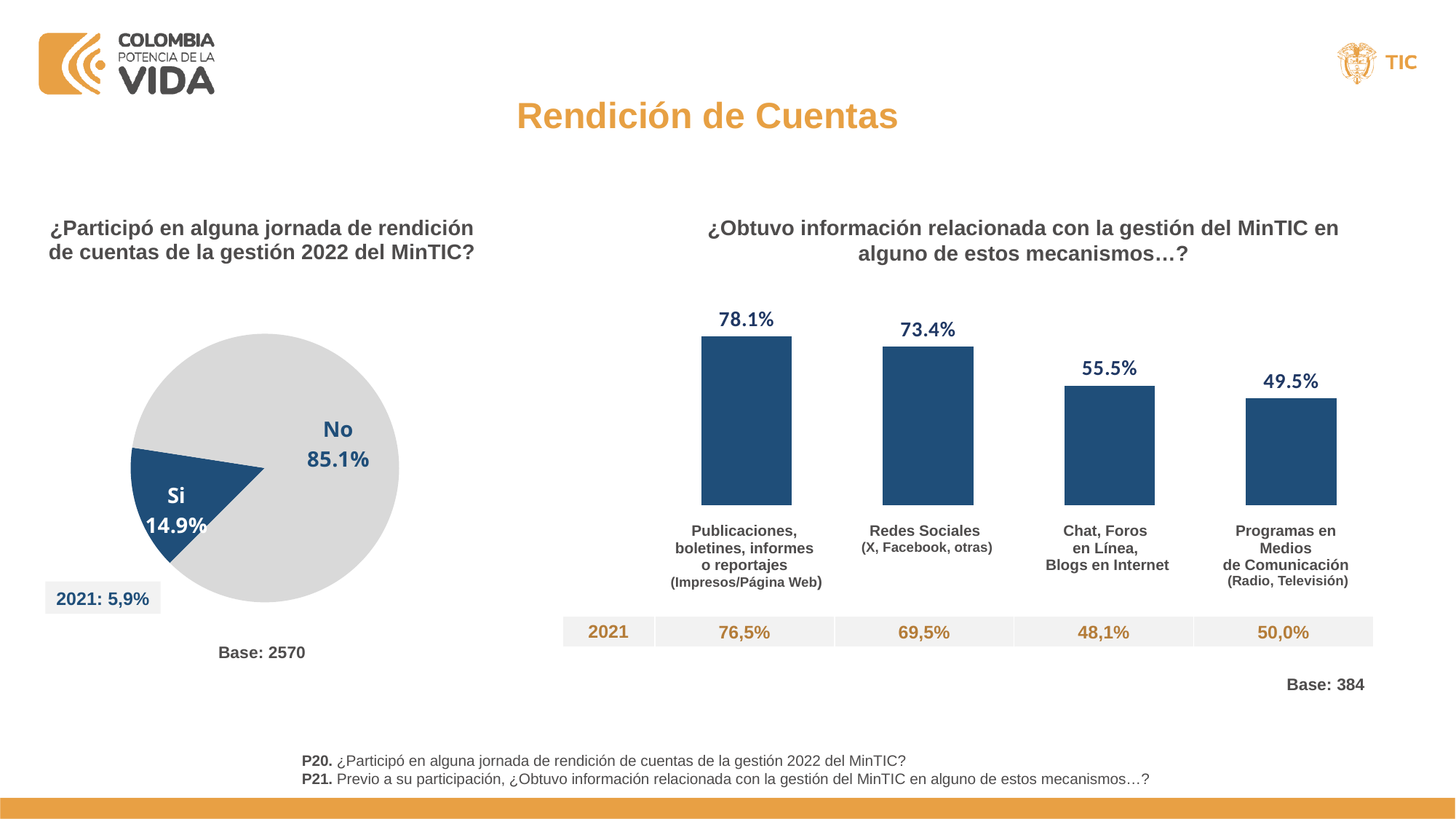
In the bar chart on the right, how many categories are shown? 4 In the bar chart on the right, what is the difference between 'Publicaciones, boletines, informes o reportajes' and 'Chat, Foros en Línea, Blogs en Internet'? 22.6% What kind of chart is shown on the right side of the slide? Bar chart In the bar chart on the right, which category has the highest value? Publicaciones, boletines, informes o reportajes (Impresos/Página Web) What kind of chart is shown on the left side of the slide? Pie chart In the bar chart on the right, what is the value for 'Programas en Medios de Comunicación (Radio, Televisión)'? 49.5% In the pie chart on the left, what was the 'Si' value in 2021? 5,9% In the bar chart on the right, what was the 2021 value for 'Chat, Foros en Línea, Blogs en Internet'? 48,1% In the pie chart on the left, what percentage answered 'Si'? 14.9% In the pie chart on the left, what percentage answered 'No'? 85.1% In the bar chart on the right, what is the value for 'Redes Sociales (X, Facebook, otras)'? 73.4% In the bar chart on the right, which category has the lowest value? Programas en Medios de Comunicación (Radio, Televisión)